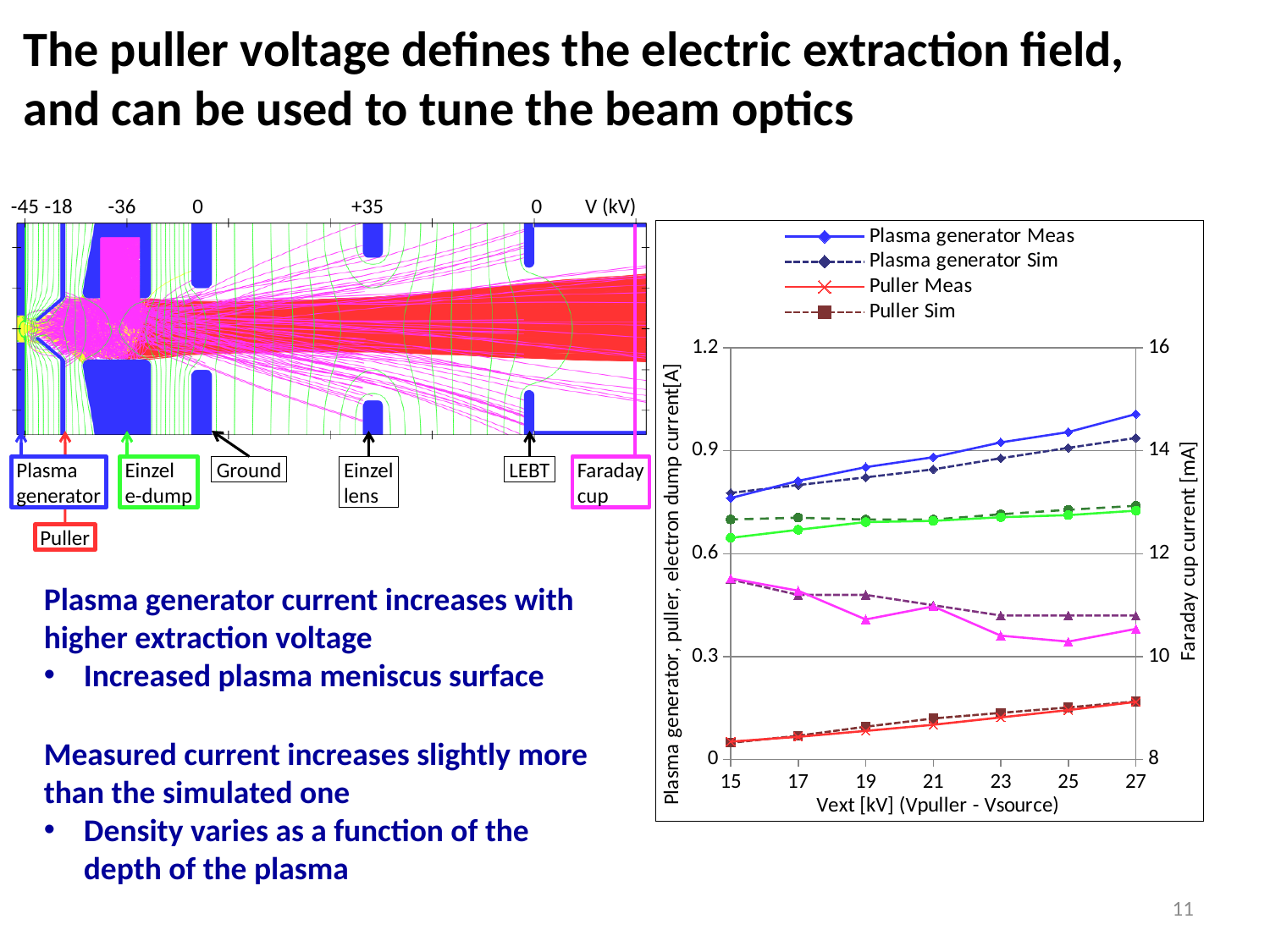
Does the Puller Meas series rise or fall as Vext increases from 15 to 27 kV? rise How many Vext values are plotted along the x axis of the chart (from 15 to 27 kV)? 7 At Vext = 27 kV, which is larger: Plasma generator Meas or Puller Meas? Plasma generator Meas What is the label of the x axis of the chart? Vext [kV] (Vpuller - Vsource) What kind of chart is shown on the right of the slide? line chart Is the Plasma generator Meas value at Vext = 27 kV greater or less than 0.9 A? greater Is the Puller Sim value at Vext = 27 kV greater or less than 0.3 A? less How many series does the legend of the chart list? 4 What is the label of the right-hand y axis of the chart? Faraday cup current [mA] Is the Puller Meas value at Vext = 15 kV greater or less than 0.3 A? less Does the Plasma generator Meas series rise or fall as Vext increases from 15 to 27 kV? rise